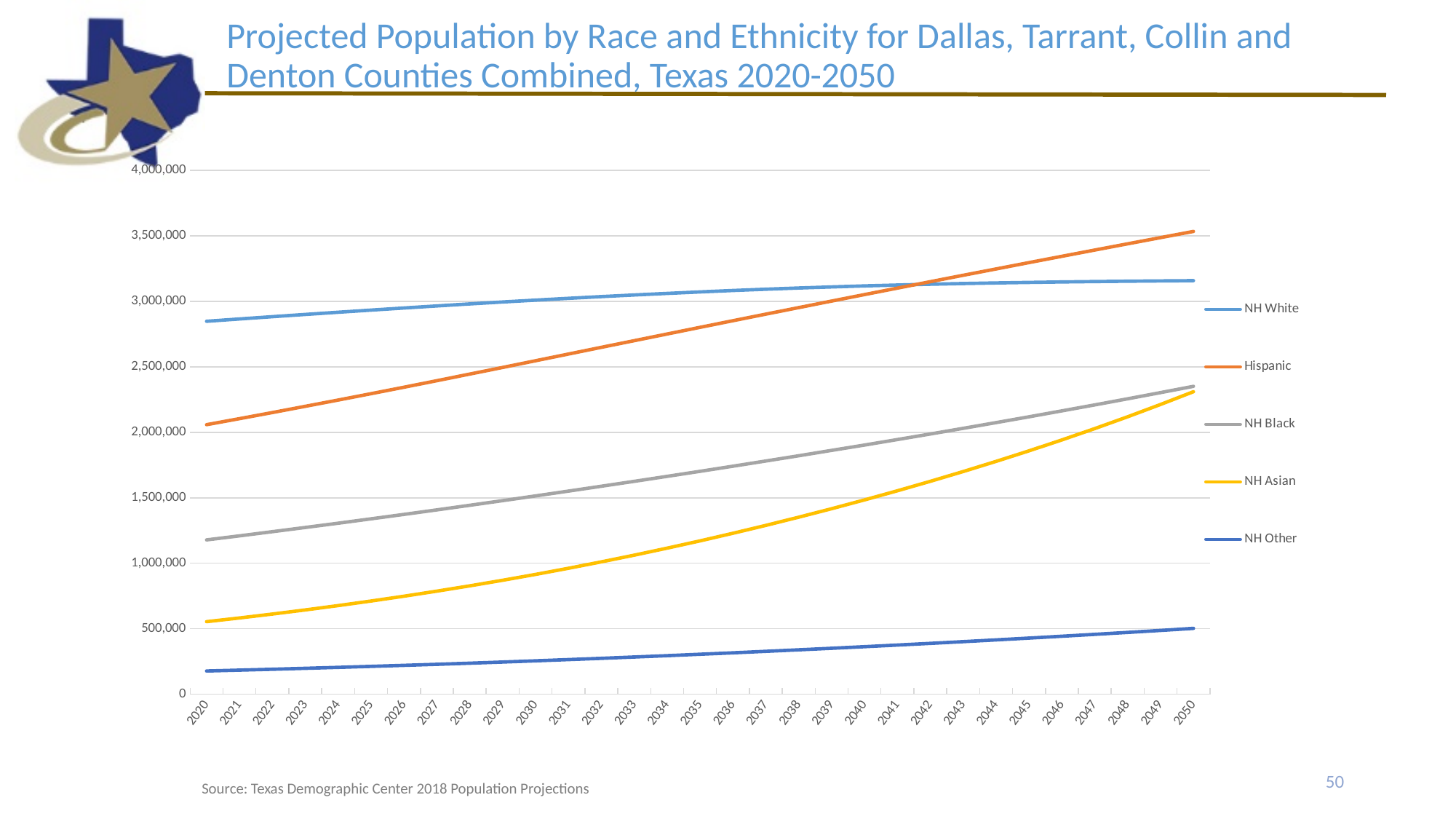
Is the NH Asian value for 2020 greater or less than 1,000,000? less Is the NH White value for 2020 greater or less than 3,000,000? less How many years are shown along the x axis? 31 Which group has the highest projected population in 2020? NH White Which group has the highest projected population in 2050? Hispanic Which group has the lowest projected population in 2050? NH Other Is the NH Black value for 2020 greater or less than 1,000,000? greater What colour is the Hispanic line in the chart? orange In 2020, which is larger: the NH White population or the Hispanic population? NH White What kind of chart is shown on the slide? line chart Does the Hispanic projected population rise or fall from 2020 to 2050? rise How many series does the legend list? 5